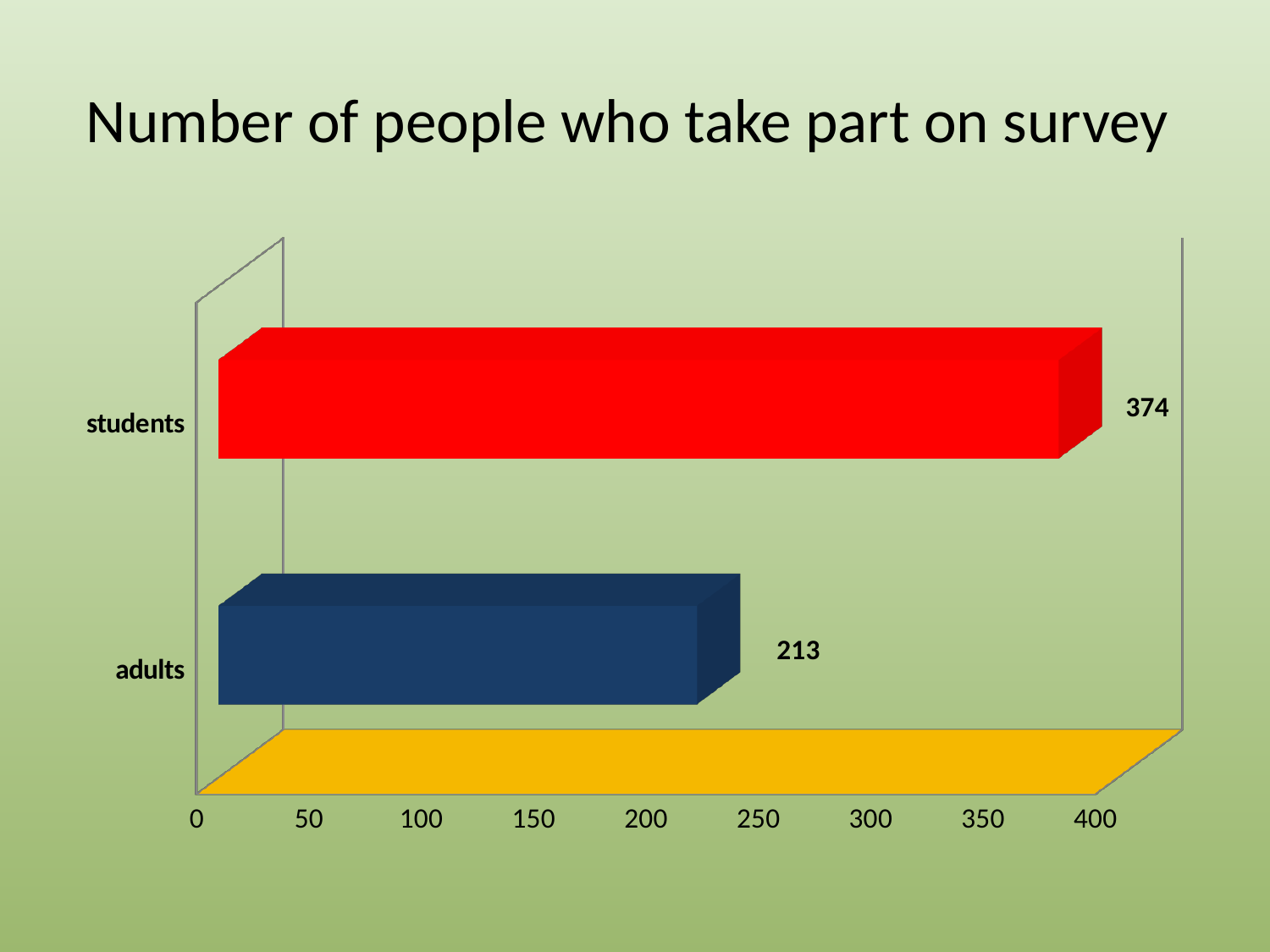
What kind of chart is shown on the slide? bar chart Which category has the highest value? students What is the difference between the values for students and adults? 161 What is the value for adults? 213 What colour is the bar for students? red Which category has the lowest value? adults What is the title of the slide? Number of people who take part on survey Is the value for students greater or less than 350? greater What is the value for students? 374 Which is larger, the value for students or the value for adults? students Is the value for adults greater or less than 250? less How many categories are shown in the chart? 2